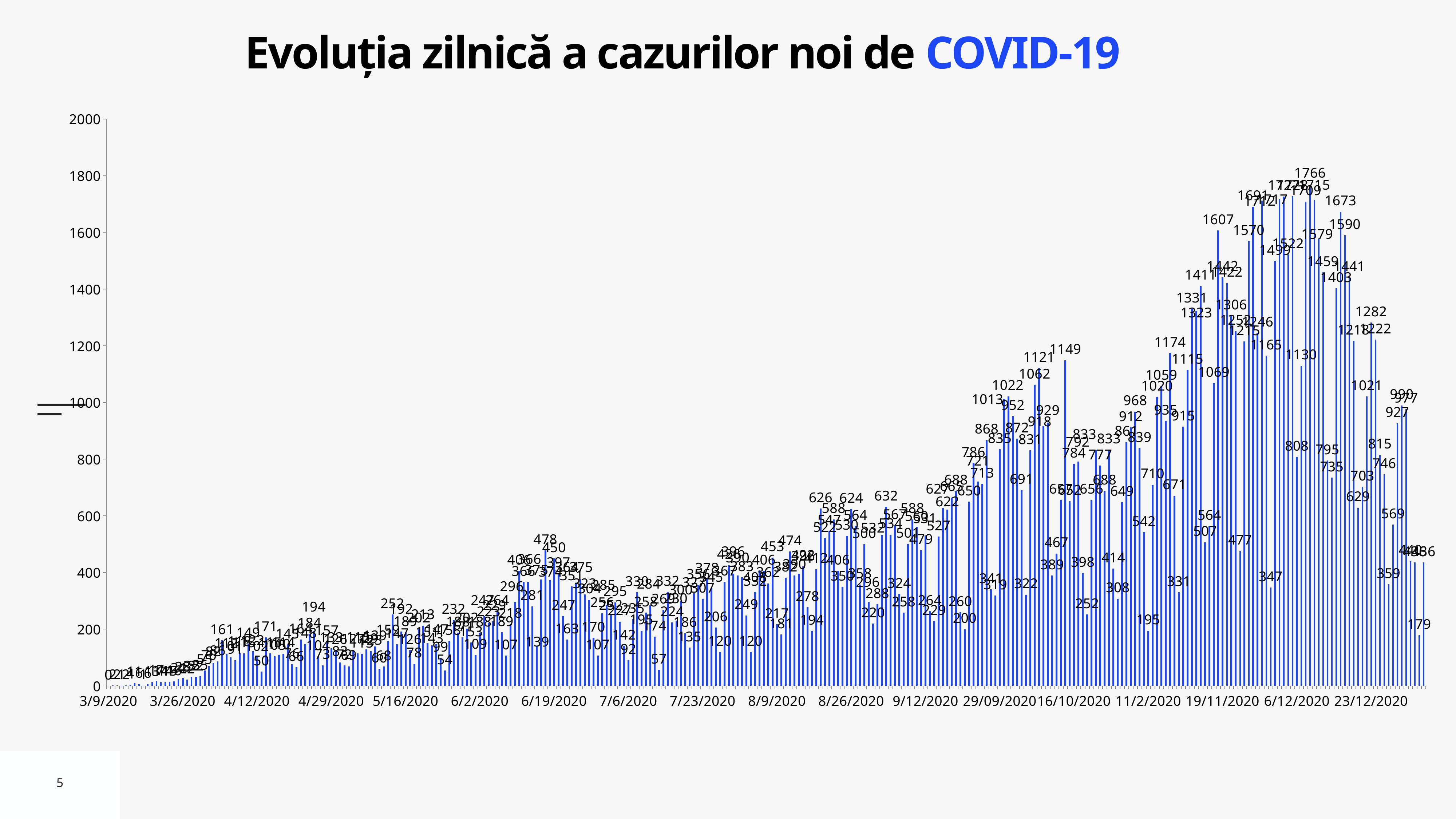
Is the tallest bar near 6/19/2020 greater or less than 600? less Which is larger, the bar labelled 478 or the bar labelled 1766? 1766 Is the value of the first bar at 3/9/2020 greater or less than 200? less What is the highest daily value labelled on the chart? 1766 What is the difference between the bars labelled 1766 and 1673? 93 What is the title of the chart? Evoluția zilnică a cazurilor noi de COVID-19 What is the highest value shown on the vertical axis? 2000 What kind of chart is shown on the slide? bar chart Overall, do the daily values rise or fall from March 2020 to December 2020? rise Is the highest value on the chart greater or less than 1800? less